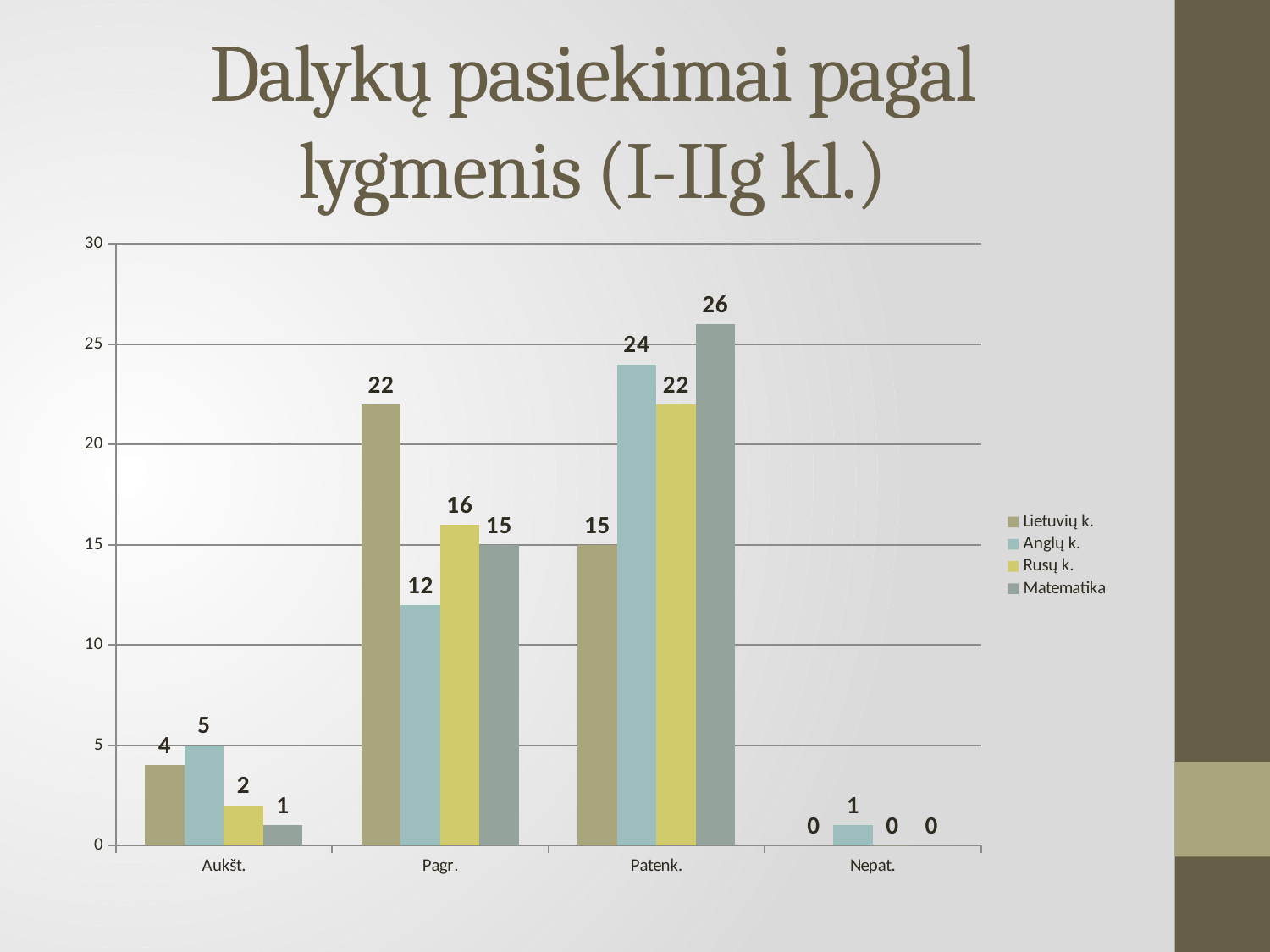
Which category has the highest value for Lietuvių k.? Pagr. What is the value for Matematika in the Patenk. category? 26 What kind of chart is shown on the slide? Bar chart How many series does the legend list? 4 What is the total of the four series values in the Nepat. category? 1 What is the value for Rusų k. in the Aukšt. category? 2 What is the difference between the Anglų k. and Lietuvių k. values in the Patenk. category? 9 How many categories are shown on the x axis? 4 Which is larger in the Pagr. category: Rusų k. or Matematika? Rusų k. What is the value for Anglų k. in the Pagr. category? 12 Which series has the lowest value in the Aukšt. category? Matematika What is the title of the chart? Dalykų pasiekimai pagal lygmenis (I-IIg kl.)